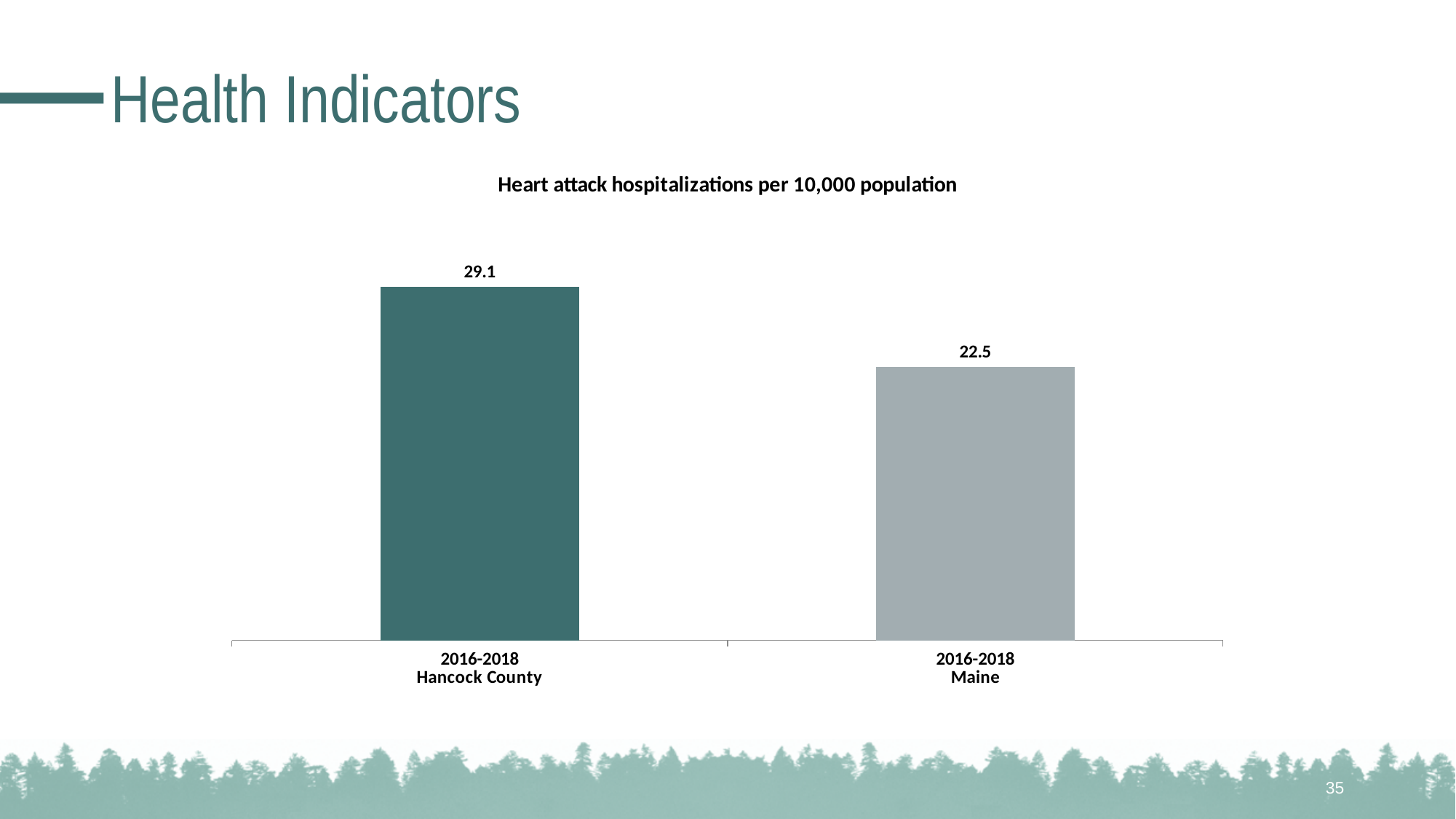
What is the heart attack hospitalization rate per 10,000 population for Maine in 2016-2018? 22.5 What time period do both bars in the chart cover? 2016-2018 Which category has the lower heart attack hospitalization rate? Maine Is the heart attack hospitalization rate for Maine larger or smaller than that for Hancock County? smaller How many categories are shown in the chart? 2 What is the title of the chart? Heart attack hospitalizations per 10,000 population What is the heart attack hospitalization rate per 10,000 population for Hancock County in 2016-2018? 29.1 What kind of chart is shown on the slide? bar chart What is the difference between the Hancock County and Maine heart attack hospitalization rates? 6.6 Which category has the higher heart attack hospitalization rate, Hancock County or Maine? Hancock County